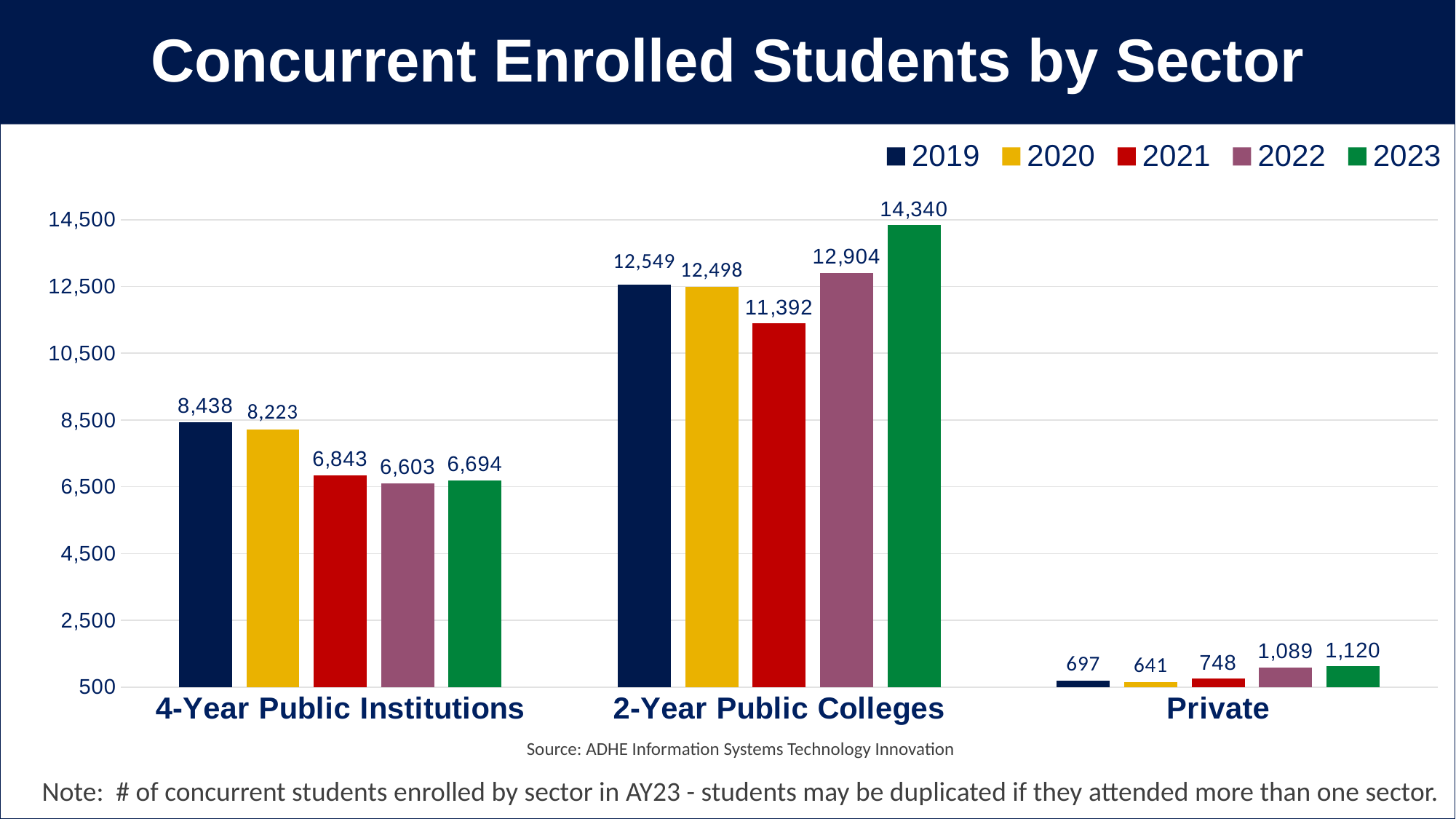
Which year has the highest value for 2-Year Public Colleges? 2023 What is the value for 4-Year Public Institutions in 2019? 8,438 What is the value for Private in 2022? 1,089 Is the 2021 value for 2-Year Public Colleges greater or less than 10,500? greater What kind of chart is shown on the slide? bar chart What is the title of the chart? Concurrent Enrolled Students by Sector Which is larger: the 2021 value for 4-Year Public Institutions or the 2021 value for Private? 4-Year Public Institutions How many sector categories are shown on the x axis? 3 What is the difference between the 2023 and 2019 values for 2-Year Public Colleges? 1,791 Which year has the lowest value for 4-Year Public Institutions? 2022 How many series does the legend list? 5 What is the value for 2-Year Public Colleges in 2023? 14,340